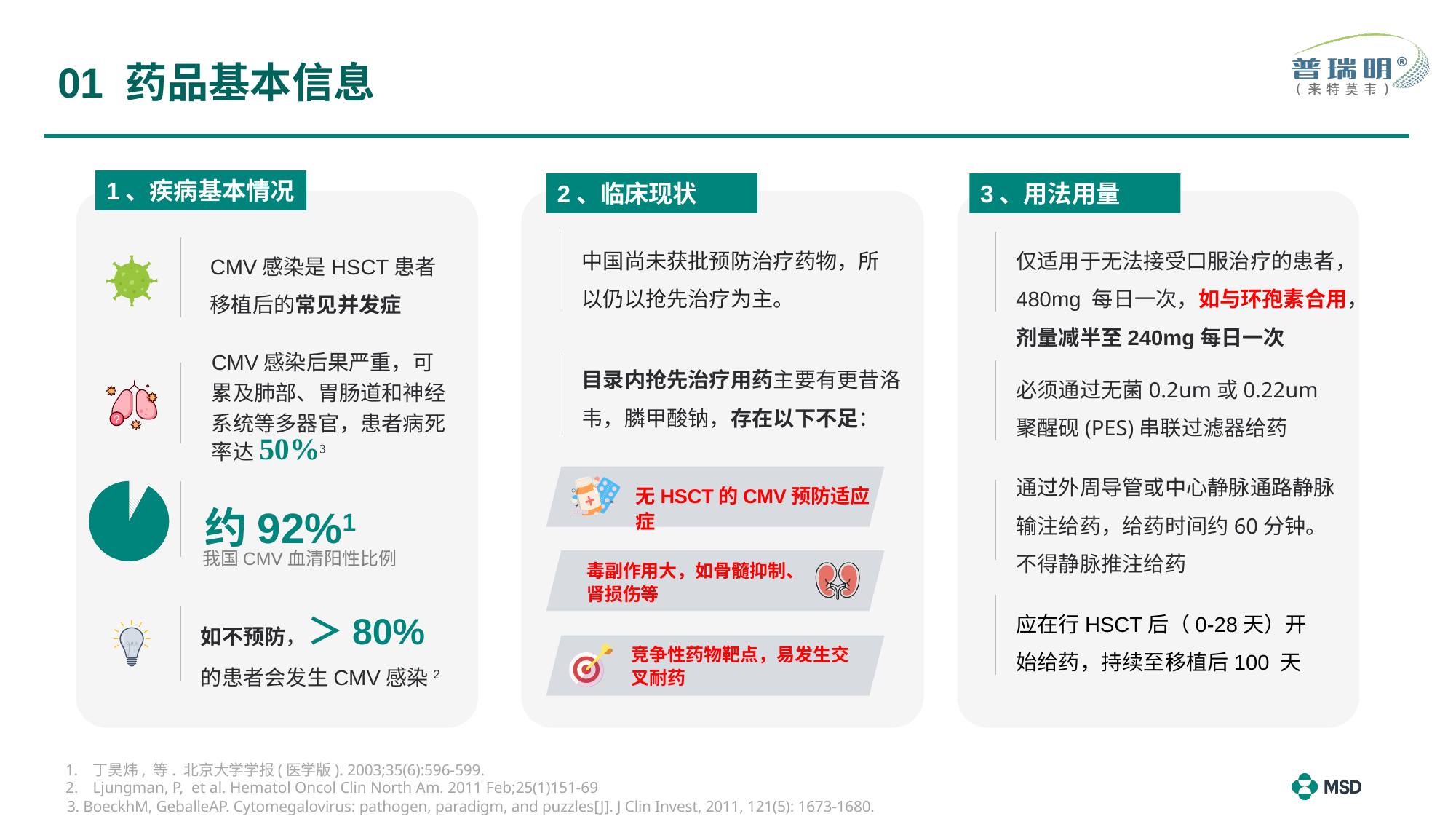
What does the pie chart in the first panel represent, according to the label beneath the 92% figure? 我国 CMV 血清阳性比例 Which reference number is cited for the 92% value shown with the pie chart? 1 In the pie chart in the first panel, what share does the highlighted slice represent, as printed on the slide? 约 92% What kind of chart is shown in the first panel (1、疾病基本情况) next to the 92% figure? pie chart Is the share shown by the pie chart in the first panel greater or less than 50%? greater